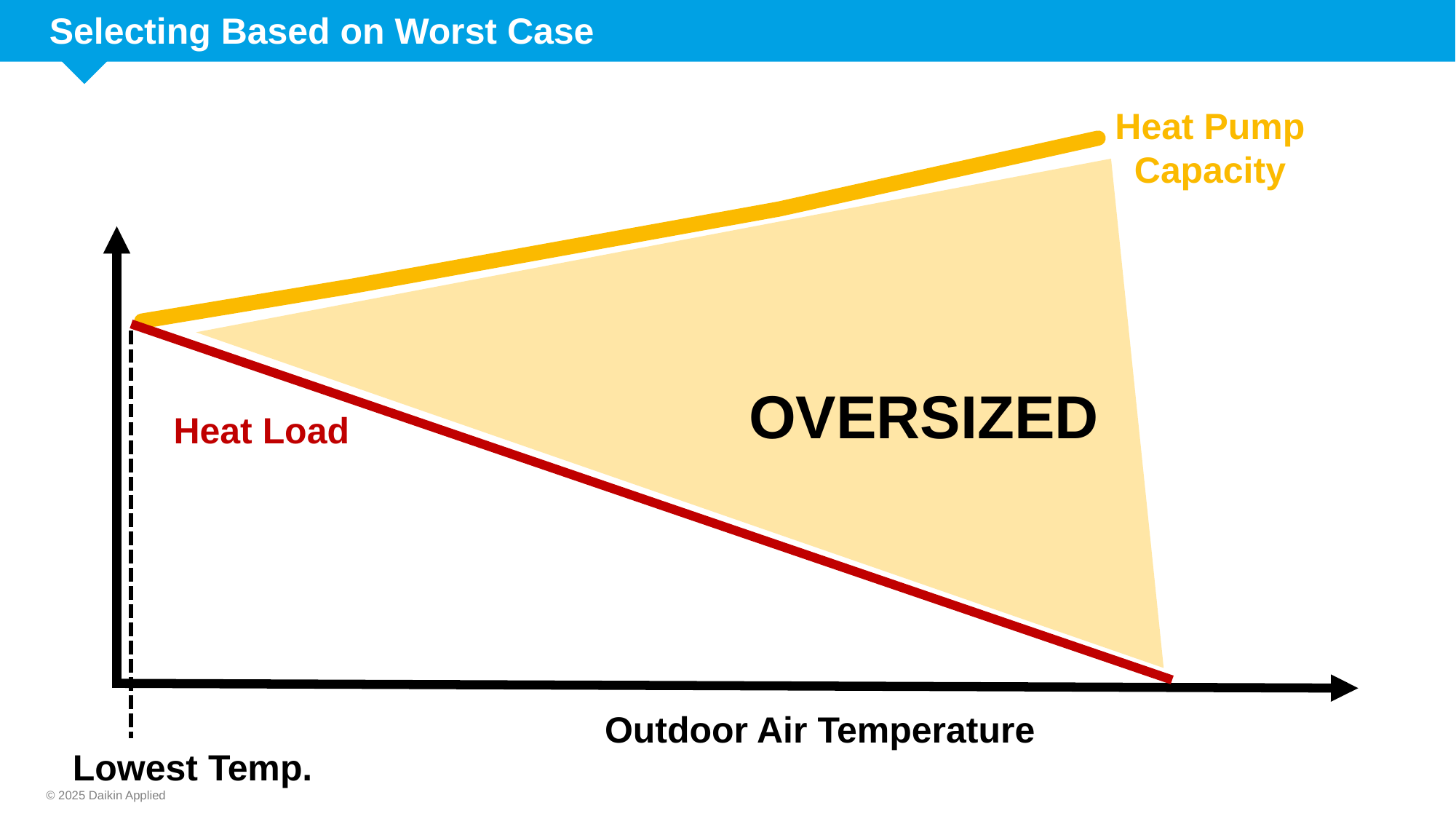
At the highest Outdoor Air Temperature shown, which is larger, Heat Pump Capacity or Heat Load? Heat Pump Capacity Does the Heat Pump Capacity line rise or fall as Outdoor Air Temperature increases? Rise Does the Heat Load line rise or fall as Outdoor Air Temperature increases? Fall What label marks the dashed vertical line at the left of the chart? Lowest Temp. What kind of chart is shown on the slide? Line chart How many lines (series) are plotted on the chart? 2 What is the title of the slide containing the chart? Selecting Based on Worst Case What word labels the shaded region between the two lines? OVERSIZED